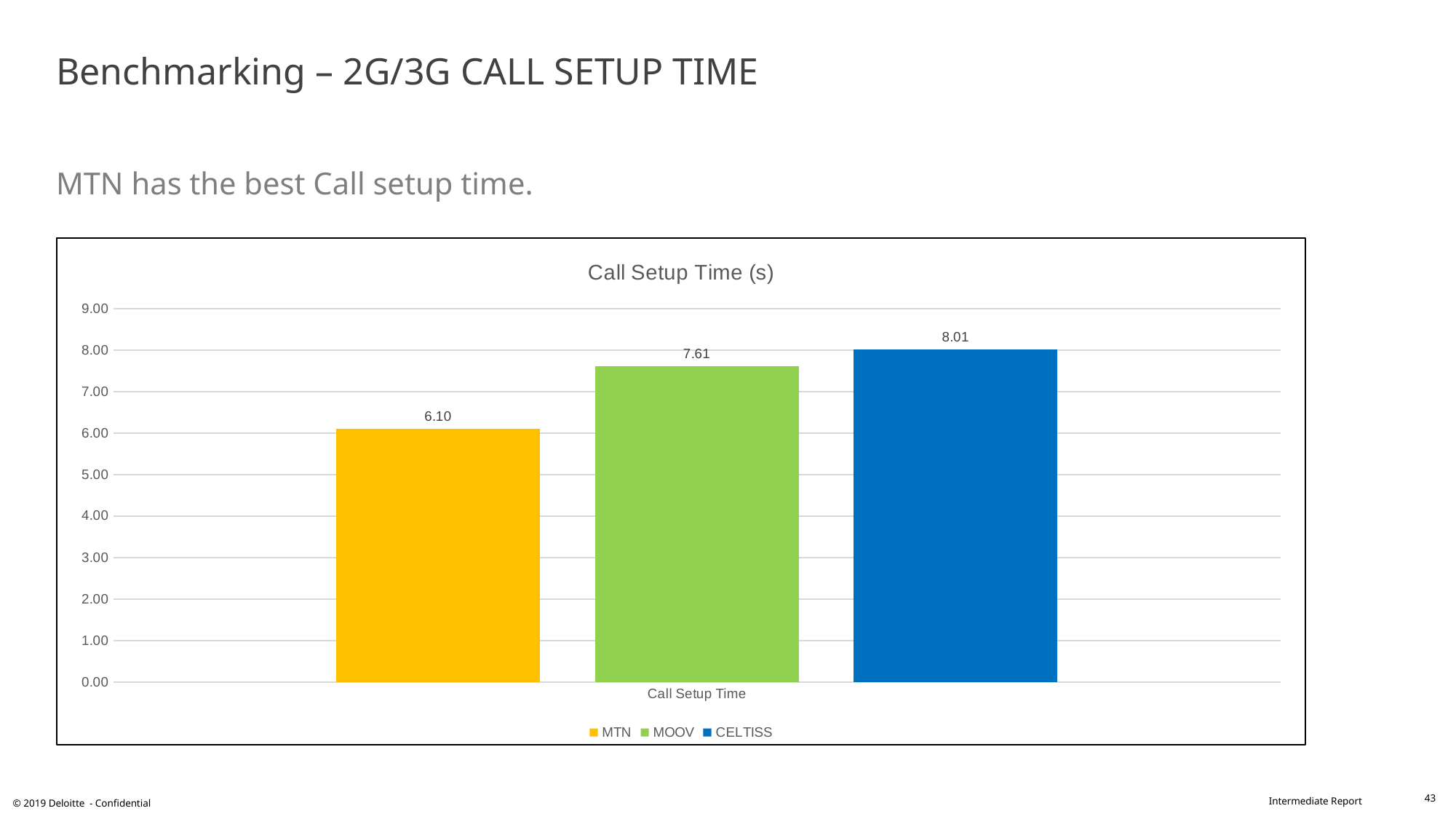
What is the call setup time for MTN? 6.10 Which operator has the highest call setup time? CELTISS What is the call setup time for MOOV? 7.61 What is the title of the chart? Call Setup Time (s) How many series does the legend list? 3 What is the call setup time for CELTISS? 8.01 What kind of chart is shown on the slide? Bar chart What is the difference between the call setup times of MOOV and MTN? 1.51 Is the call setup time for MOOV greater or less than 7.00? greater Which operator has the lowest call setup time? MTN What is the difference between the call setup times of CELTISS and MTN? 1.91 Which has a larger call setup time, MOOV or CELTISS? CELTISS